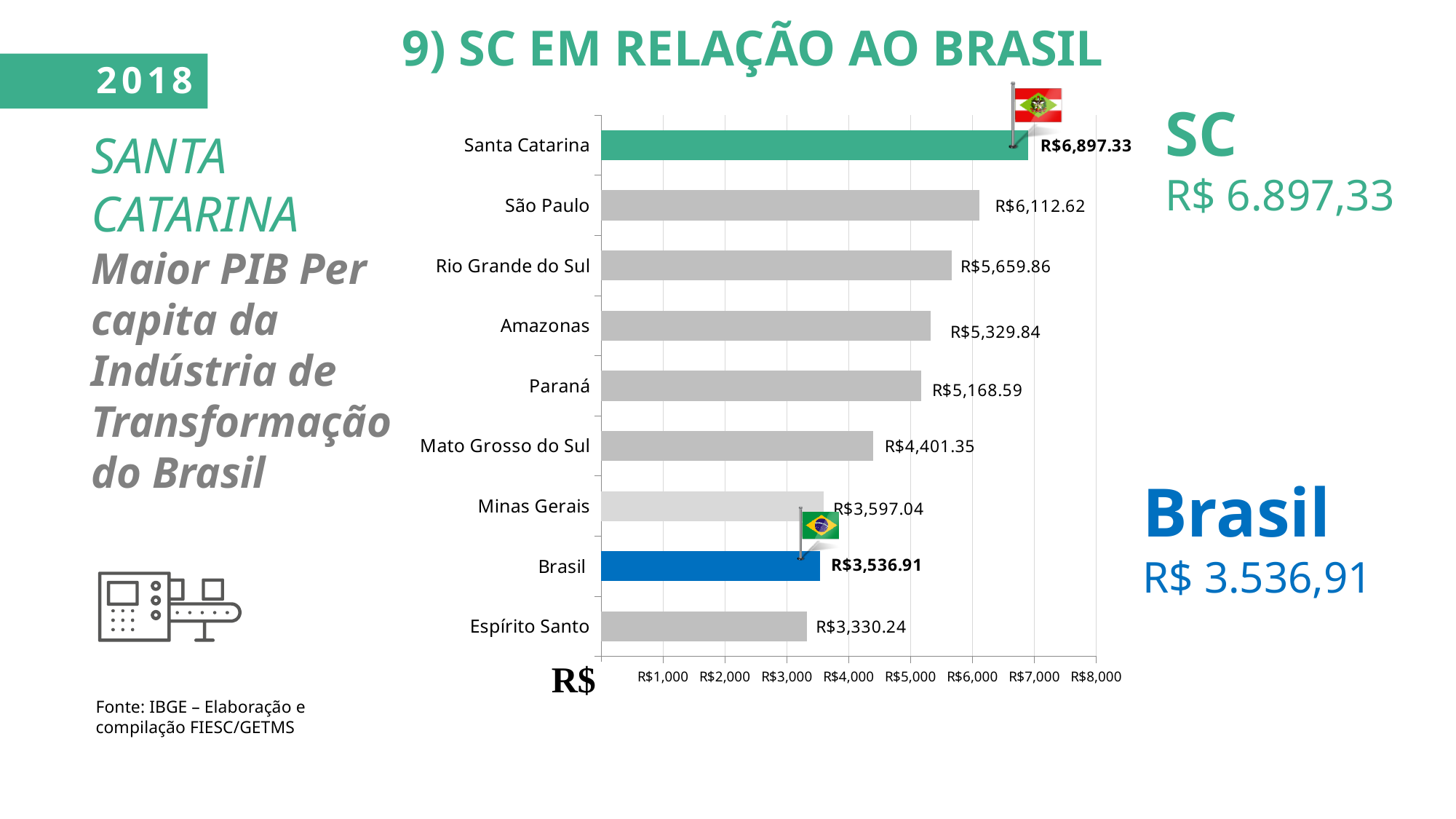
What colour is the bar for Brasil? blue How many categories are shown in the chart? 9 What is the value for Brasil? R$3,536.91 What is the value for Amazonas? R$5,329.84 Which is larger, the value for Paraná or the value for Mato Grosso do Sul? Paraná Which category has the lowest value? Espírito Santo What is the difference between the values for São Paulo and Rio Grande do Sul? R$452.76 Is the value for Minas Gerais greater or less than R$4,000? less What is the difference between the values for Santa Catarina and Brasil? R$3,360.42 What kind of chart is shown on the slide? bar chart Which category has the highest value? Santa Catarina What is the value for Santa Catarina? R$6,897.33